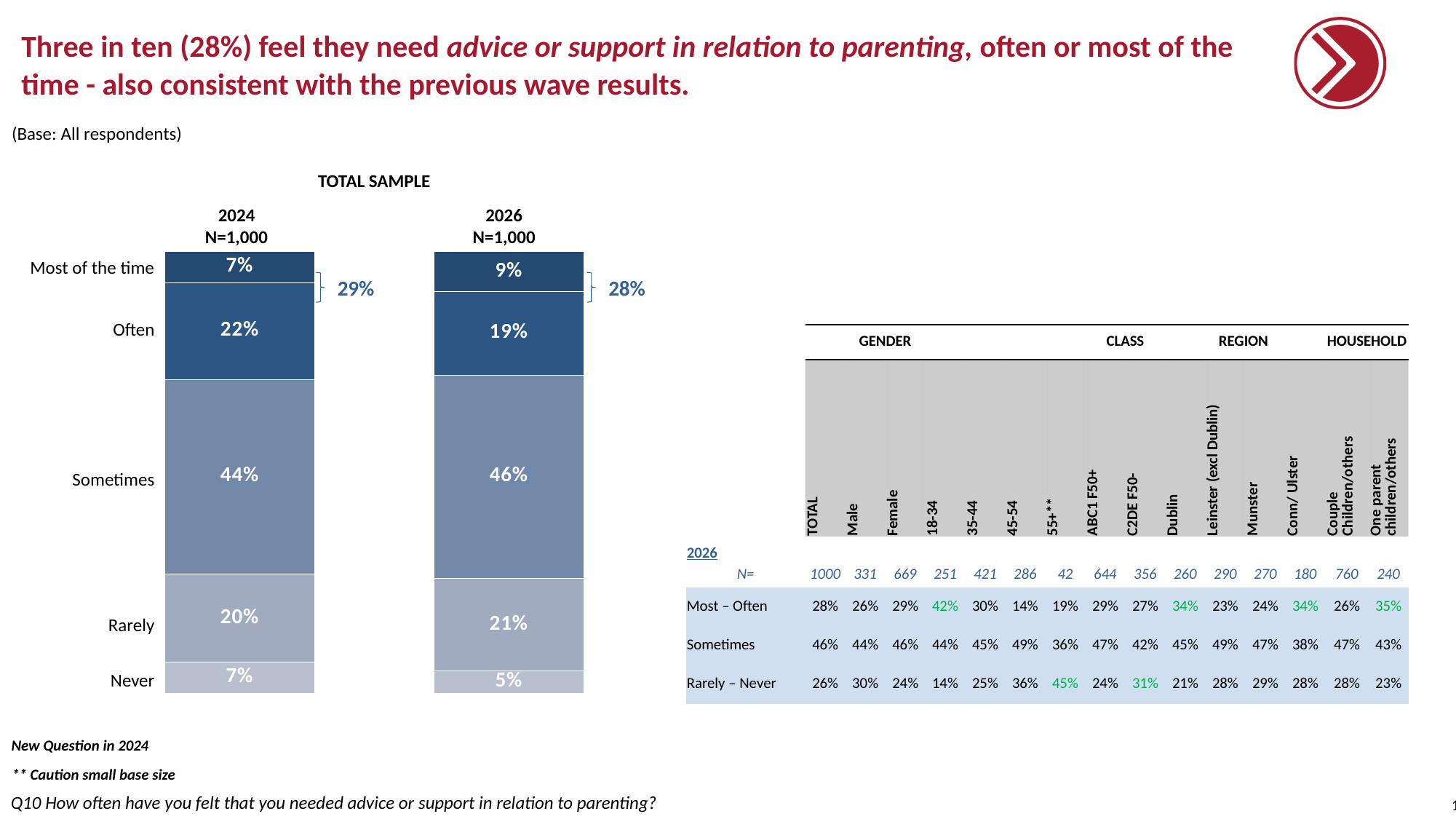
What is the sample size (N) shown for each of the 2024 and 2026 bars? N=1,000 Which response category has the smallest share in the 2026 bar? Never How many bars are shown in the chart? 2 Which response category has the largest share in the 2024 bar? Sometimes What percentage of respondents in 2026 answered 'Never'? 5% Which year has the higher 'Most of the time' percentage, 2024 or 2026? 2026 What is the combined 'Most of the time' plus 'Often' figure shown for the 2026 bar? 28% What percentage of respondents in 2026 said they need advice or support in relation to parenting 'Sometimes'? 46% By how many percentage points did the 'Often' response change from 2024 to 2026? 3 percentage points (22% to 19%) What percentage of respondents in 2024 answered 'Often'? 22% What type of chart is used to show the total sample results? Stacked bar chart How many response categories are shown in each stacked bar? 5